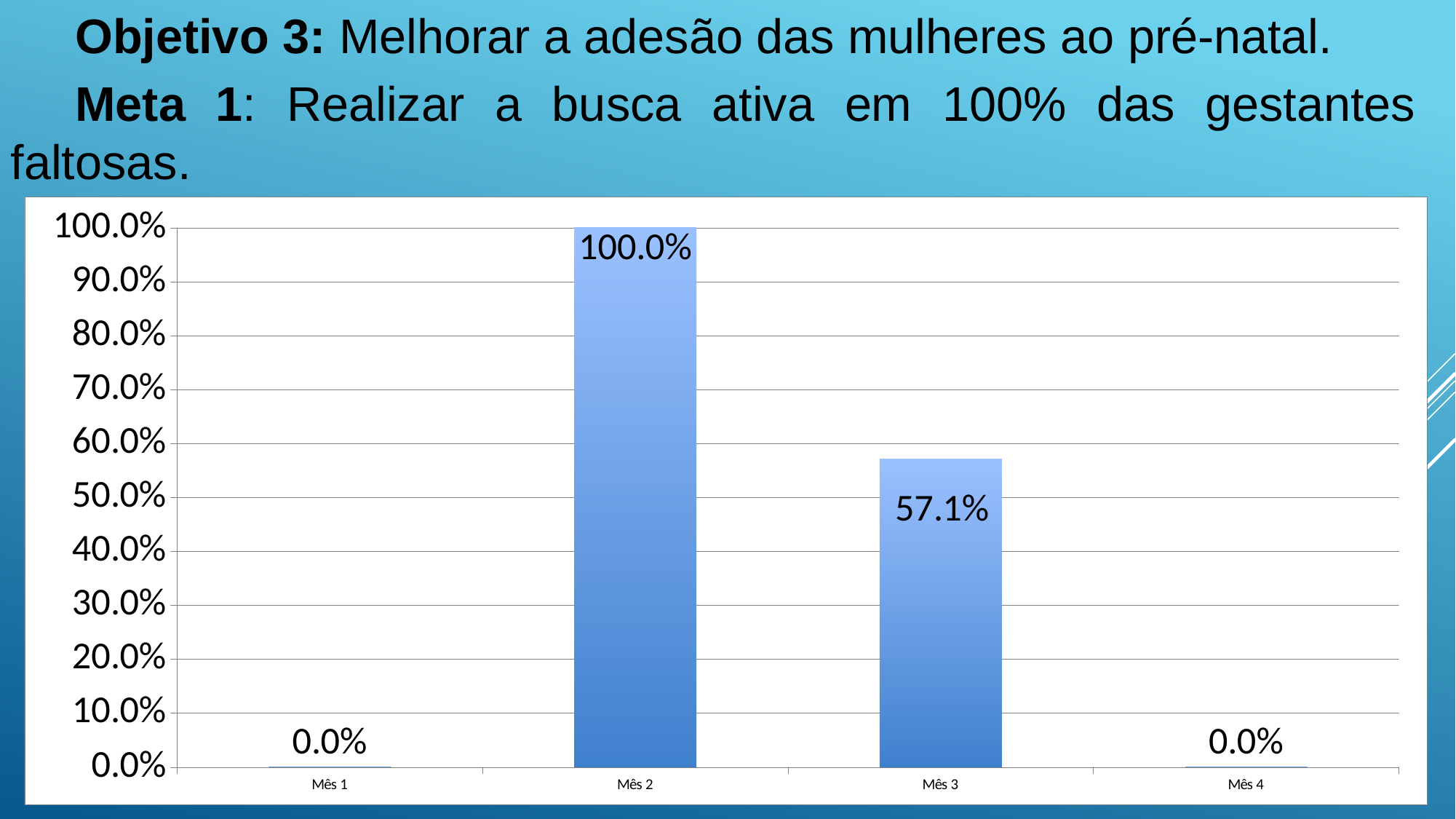
What is the highest value shown on the y axis? 100.0% What kind of chart is shown on the slide? bar chart Which month has the highest value? Mês 2 What is the difference between the values for Mês 2 and Mês 3? 42.9% Does the value rise or fall from Mês 2 to Mês 3? fall What is the value for Mês 2? 100.0% Which is larger, the value for Mês 2 or the value for Mês 3? Mês 2 Is the value for Mês 3 greater or less than 50.0%? greater How many months are shown on the x axis? 4 What is the value for Mês 1? 0.0% What is the value for Mês 4? 0.0% What is the value for Mês 3? 57.1%